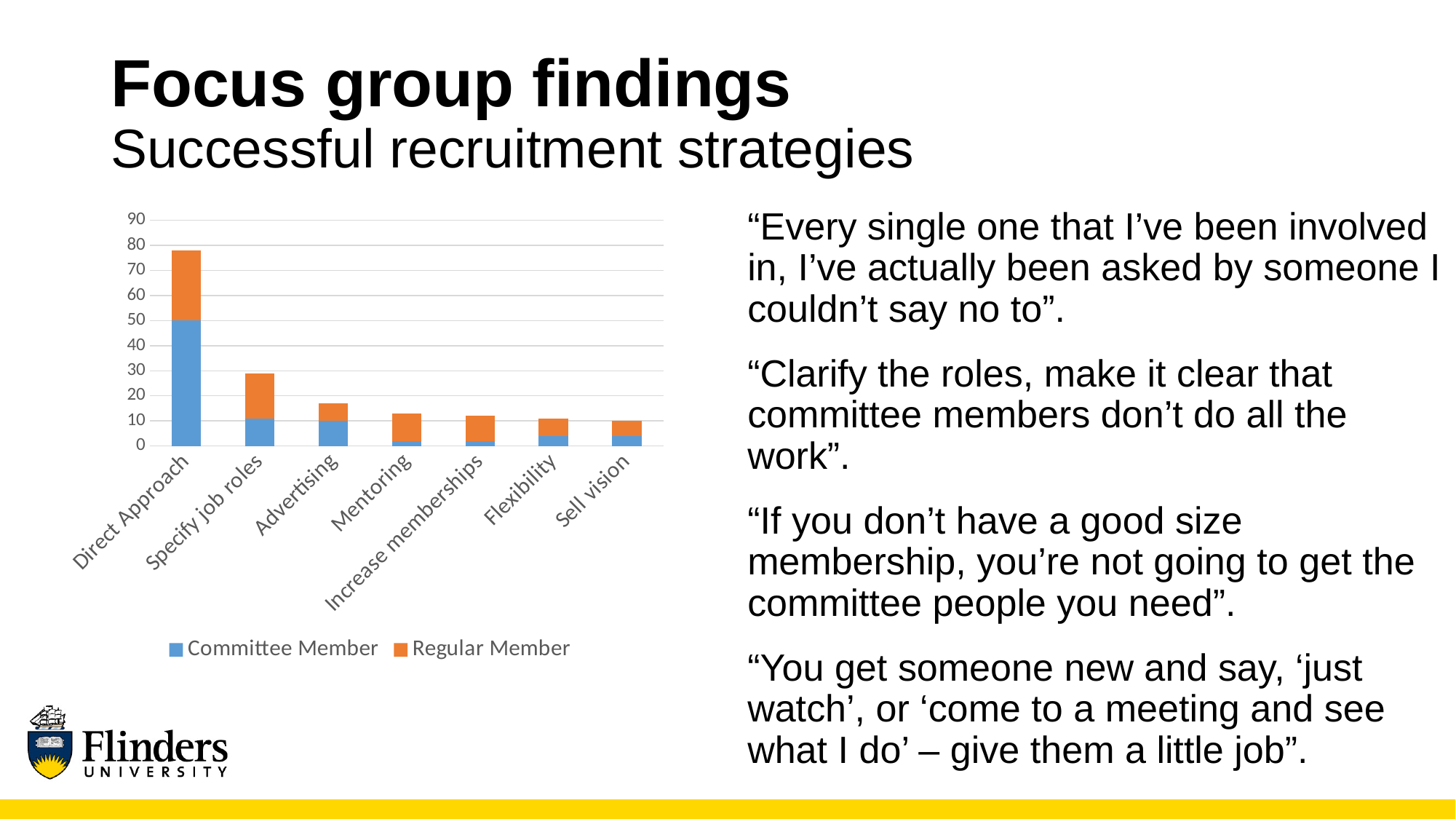
Which series is shown in orange in the chart's legend? Regular Member How many series does the chart's legend list? 2 How many recruitment strategies (categories) are shown on the x axis of the chart? 7 What kind of chart is shown on the slide? Stacked bar chart Which has a larger total bar, Advertising or Mentoring? Advertising Which recruitment strategy has the highest total bar in the chart? Direct Approach Is the total value for Specify job roles greater or less than 20? greater Do the total bar values generally rise or fall moving from left to right along the x axis? Fall Is the total value for Advertising greater or less than 20? less Which has a larger total bar, Direct Approach or Specify job roles? Direct Approach Is the Committee Member value for Direct Approach greater or less than 40? greater